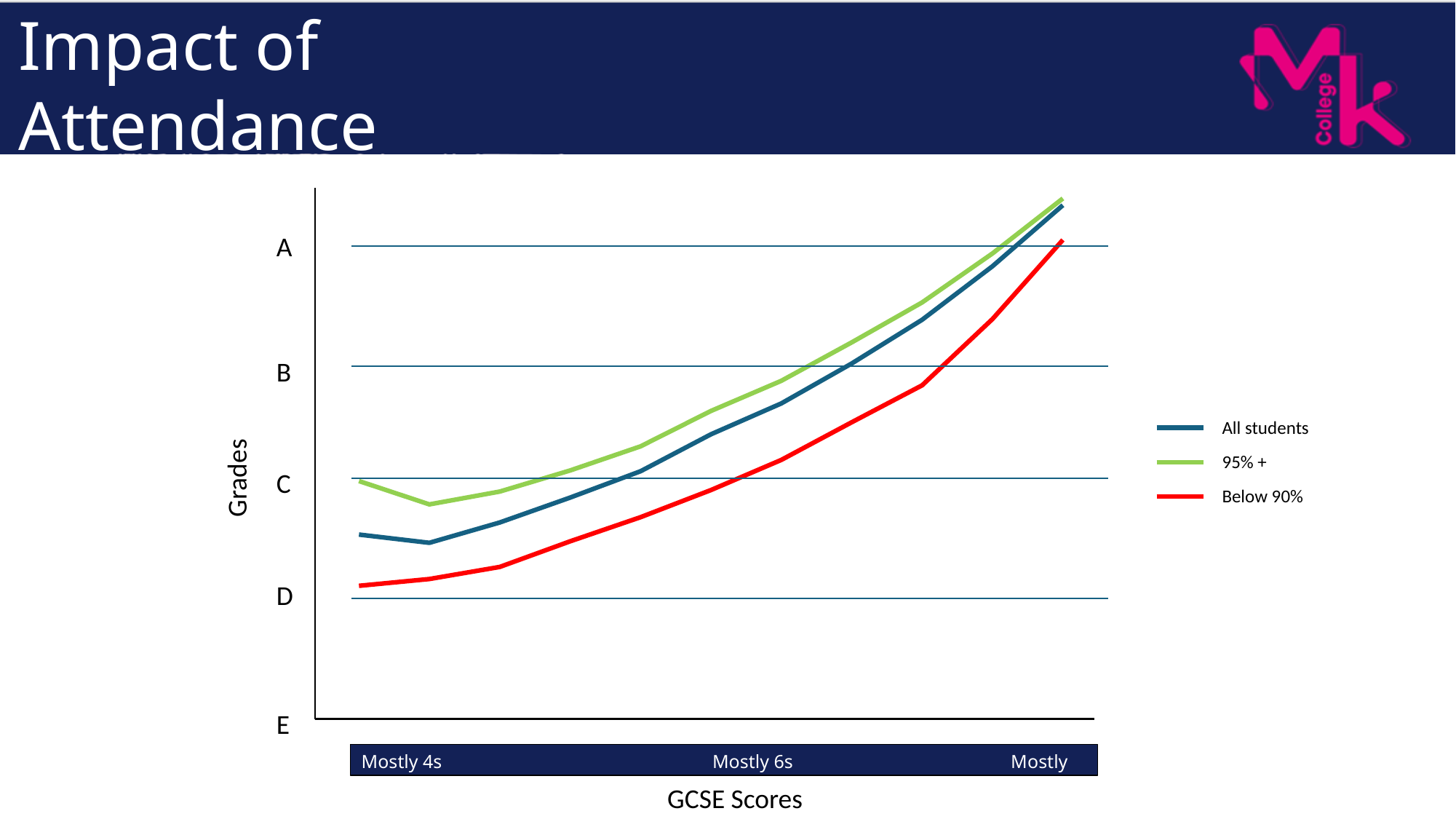
What are the titles of the vertical and horizontal axes? Grades and GCSE Scores At Mostly 4s, is the 95% + line above or below grade B? below What kind of chart is shown on the slide? line chart At Mostly 4s, which line is higher, All students or 95% +? 95% + At Mostly 4s, is the Below 90% line above or below grade D? above Which series is the lowest line across the chart? Below 90% At Mostly 6s, is the All students line above or below grade C? above How many series does the legend list? 3 Do the lines generally rise or fall as GCSE scores increase from Mostly 4s to the right? rise At Mostly 6s, which line is higher, 95% + or Below 90%? 95% + Which series is the highest line across the chart? 95% + What are the three series named in the legend? All students, 95% +, Below 90%